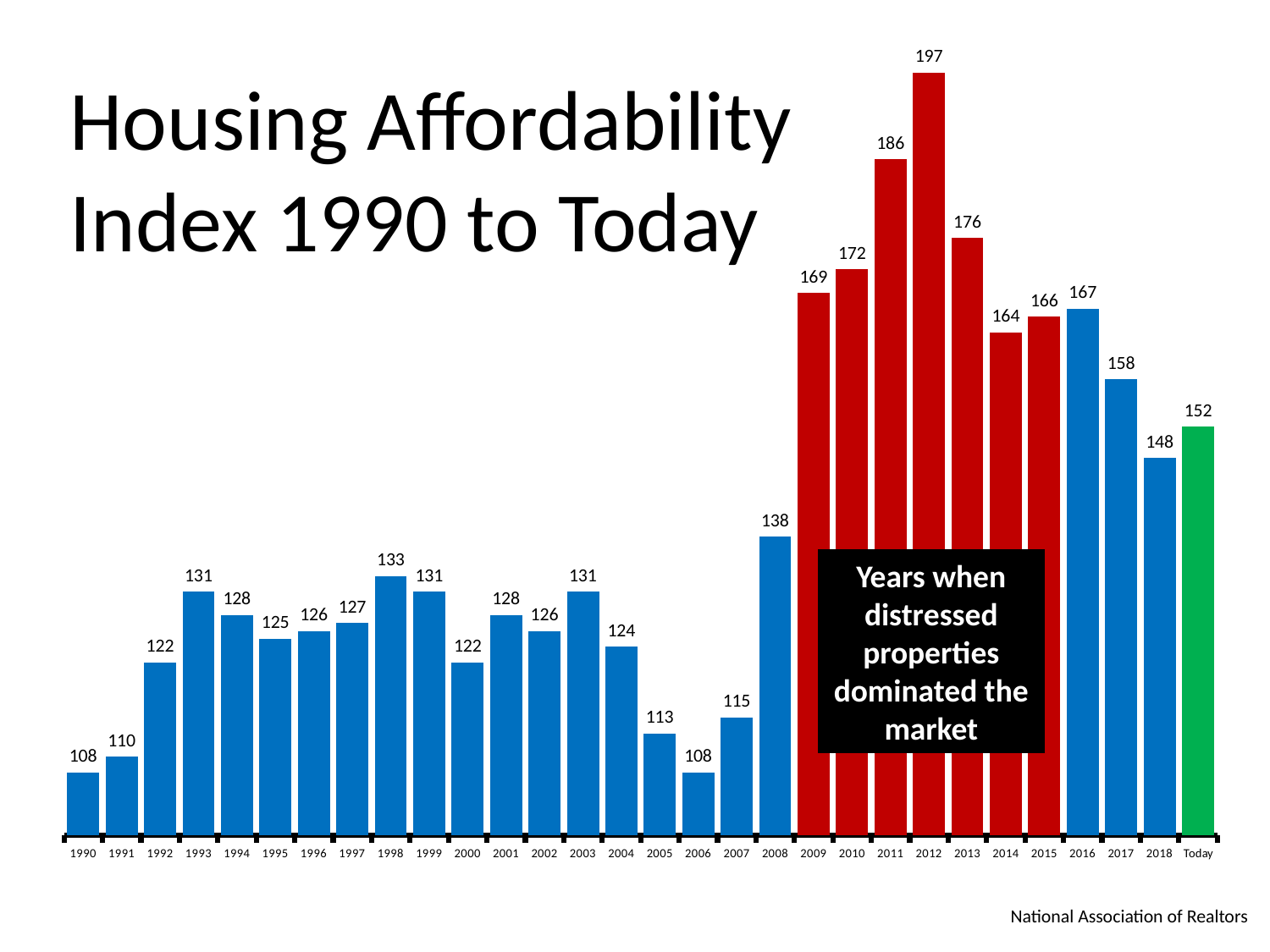
Which has a higher index value, 2016 or 2017? 2016 What is the Housing Affordability Index value for 2012? 197 What kind of chart is shown on the slide? Bar chart What is the difference between the index values for 2012 and 2018? 49 Do the index values rise or fall from 2012 to 2014? Fall What is the Housing Affordability Index value for 1998? 133 Which year has the highest Housing Affordability Index value? 2012 What is the Housing Affordability Index value for 2008? 138 What is the difference between the index values for 2009 and 2008? 31 What is the Housing Affordability Index value for Today? 152 Which has a higher index value, 2005 or 2007? 2007 How many bars are plotted in the chart? 30